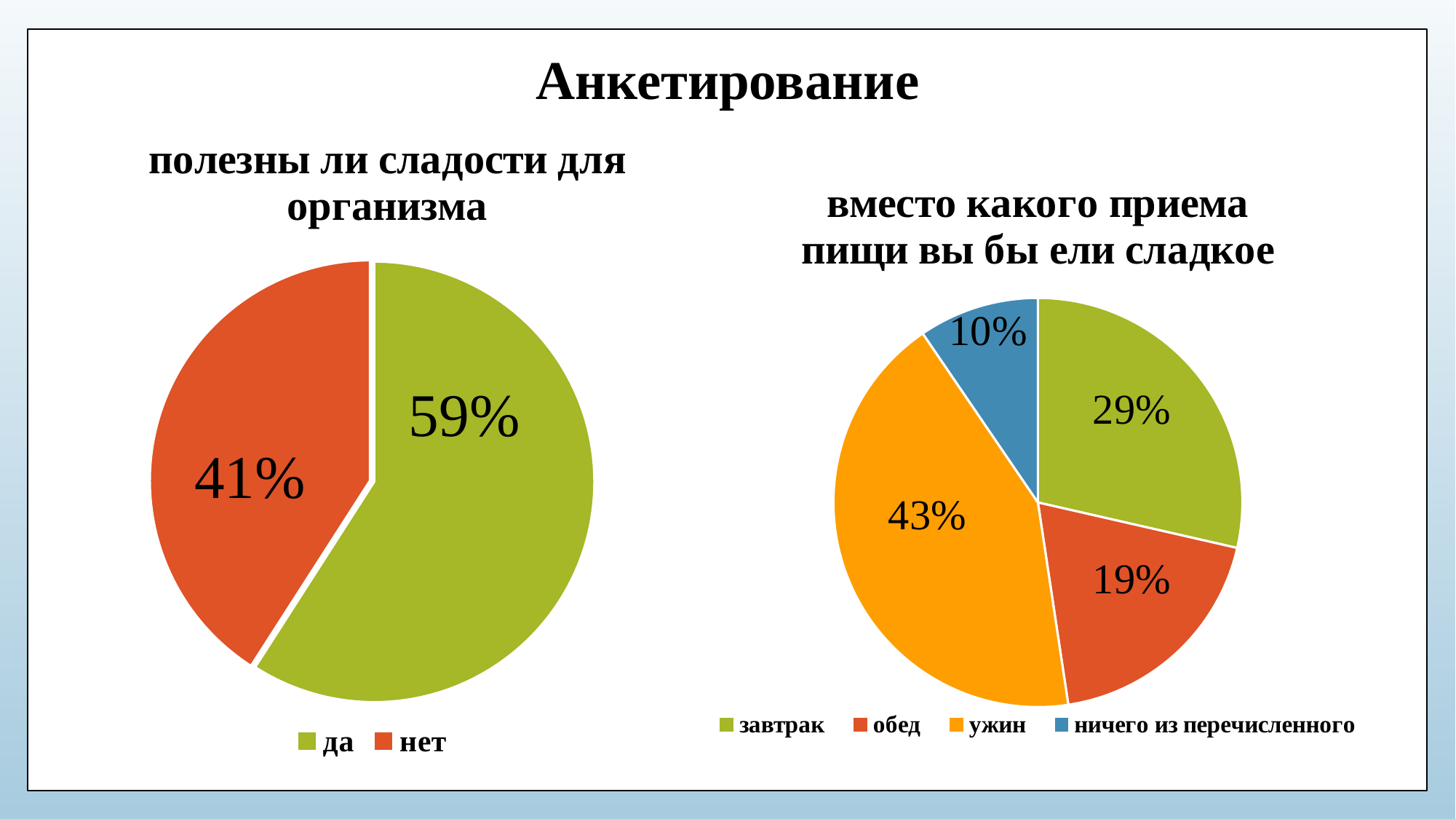
In the right chart 'вместо какого приема пищи вы бы ели сладкое', what percentage chose 'ничего из перечисленного'? 10% In the right chart 'вместо какого приема пищи вы бы ели сладкое', what percentage chose 'завтрак'? 29% In the right chart 'вместо какого приема пищи вы бы ели сладкое', which option has the smallest share? ничего из перечисленного In the left chart 'полезны ли сладости для организма', what is the difference between the 'да' and 'нет' shares? 18% In the right chart 'вместо какого приема пищи вы бы ели сладкое', how many categories does the legend list? 4 In the right chart 'вместо какого приема пищи вы бы ели сладкое', what is the difference between the 'завтрак' and 'обед' shares? 10% What kind of chart is the left chart 'полезны ли сладости для организма'? pie chart In the left chart 'полезны ли сладости для организма', which answer has the larger share? да In the left chart 'полезны ли сладости для организма', what percentage answered 'нет'? 41% In the right chart 'вместо какого приема пищи вы бы ели сладкое', what percentage chose 'ужин'? 43% In the right chart 'вместо какого приема пищи вы бы ели сладкое', which option has the largest share? ужин In the left chart 'полезны ли сладости для организма', what percentage answered 'да'? 59%